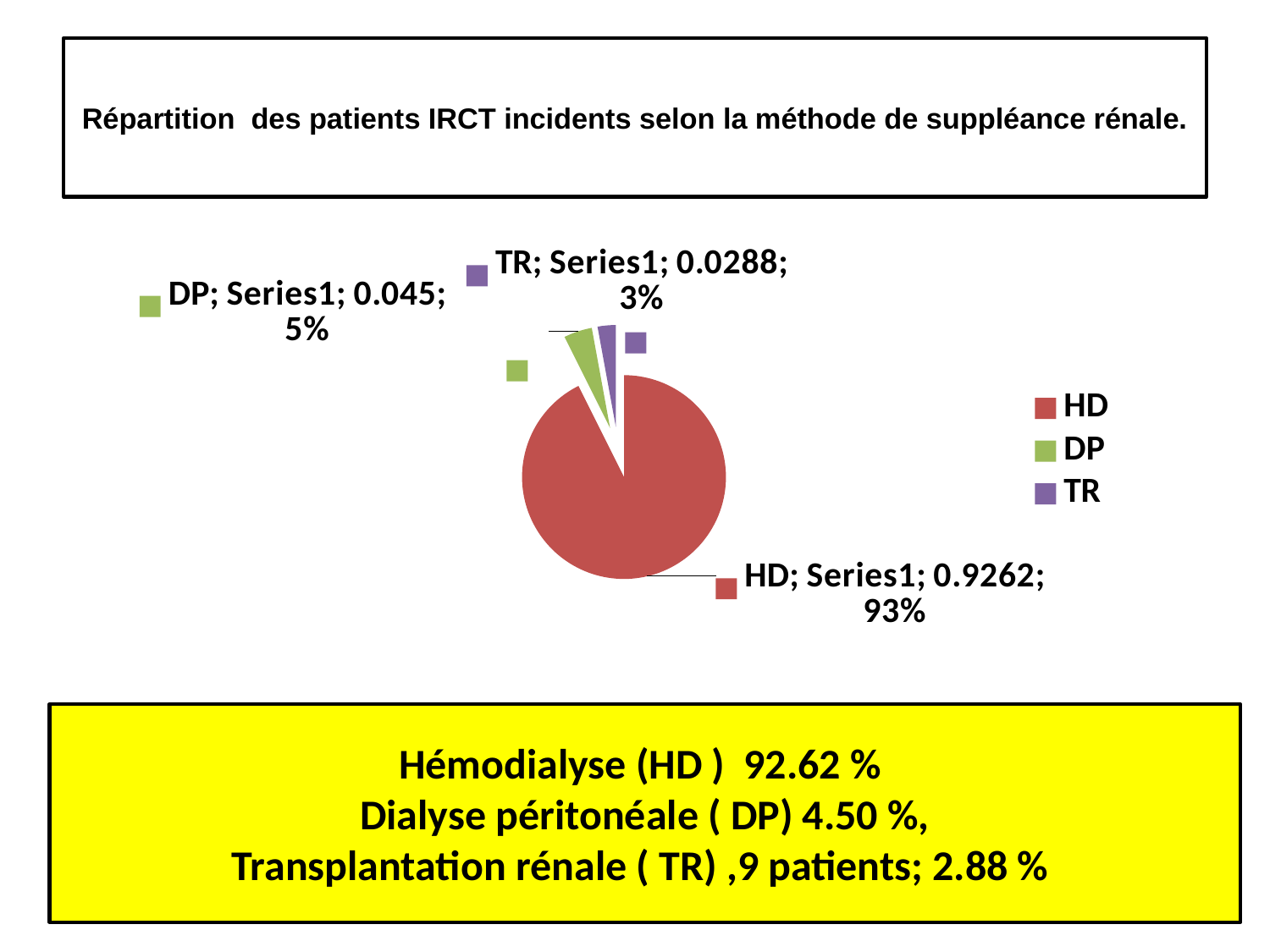
Which category has the smallest slice of the pie? TR What percentage share does the TR slice have in the pie chart? 3% What kind of chart is shown on the slide? pie chart What colour is the HD slice in the pie chart? red How many categories does the legend list? 3 What percentage share does the HD slice have in the pie chart? 93% Which category has the largest slice of the pie? HD What value is printed in the data label for DP? 0.045 What percentage share does the DP slice have in the pie chart? 5% What value is printed in the data label for TR? 0.0288 Which slice is larger, DP or TR? DP What value is printed in the data label for HD? 0.9262